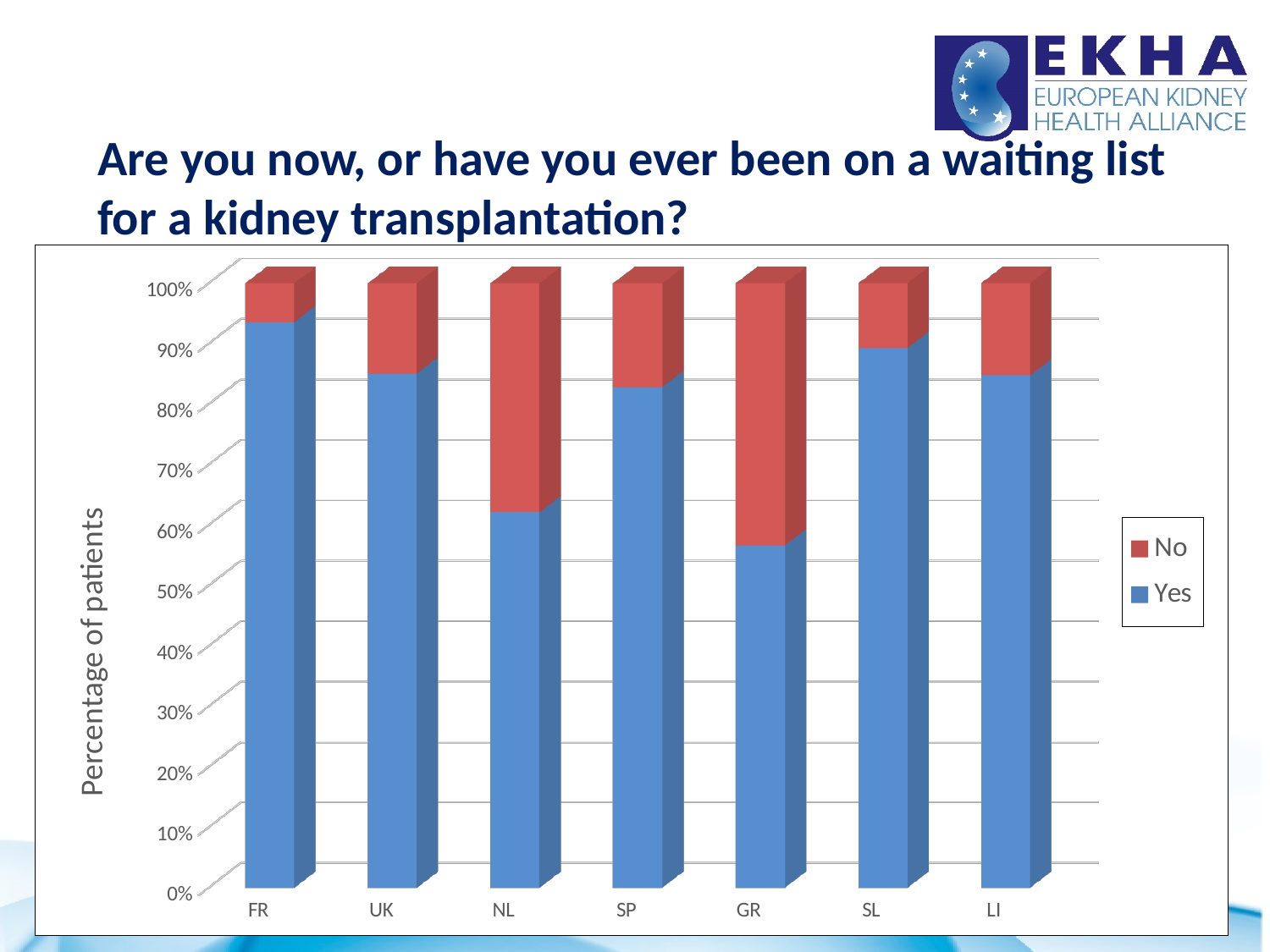
How many series does the chart's legend list? 2 Which country has the larger 'No' share, NL or GR? GR How many countries are shown along the x axis of the chart? 7 What kind of chart is shown on the slide? Stacked bar chart What is the total of the stacked bar for GR? 100% What is the label on the vertical axis of the chart? Percentage of patients Which country has the highest share of 'Yes' responses? FR Is the 'Yes' share for NL greater or less than 70%? less What are the two entries in the chart's legend? No and Yes Which country has the larger 'Yes' share, FR or SL? FR Is the 'Yes' share for FR greater or less than 90%? greater Which country has the lowest share of 'Yes' responses? GR